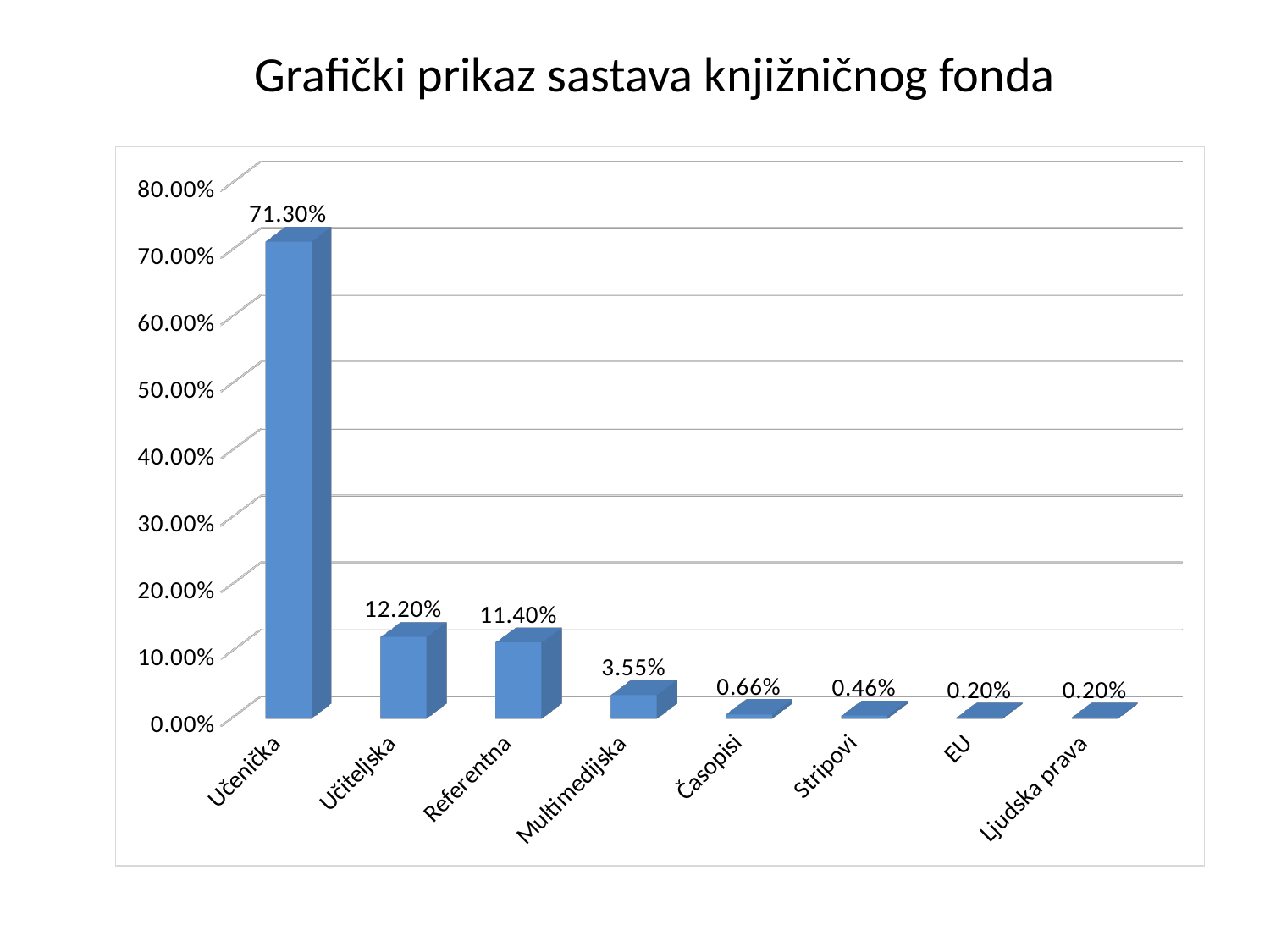
What is the value for Učenička? 71.30% Is the value for Učenička greater or less than 70.00%? greater Do the values rise or fall from left to right along the x axis? fall What is the title of the slide? Grafički prikaz sastava knjižničnog fonda How many categories are shown on the x axis? 8 What is the difference between the values for Učiteljska and Referentna? 0.80% Which is larger, the value for Referentna or the value for Multimedijska? Referentna What is the value for Stripovi? 0.46% What kind of chart is shown on the slide? bar chart What is the difference between the values for Učenička and Učiteljska? 59.10% What is the value for Multimedijska? 3.55% Which category has the highest value? Učenička